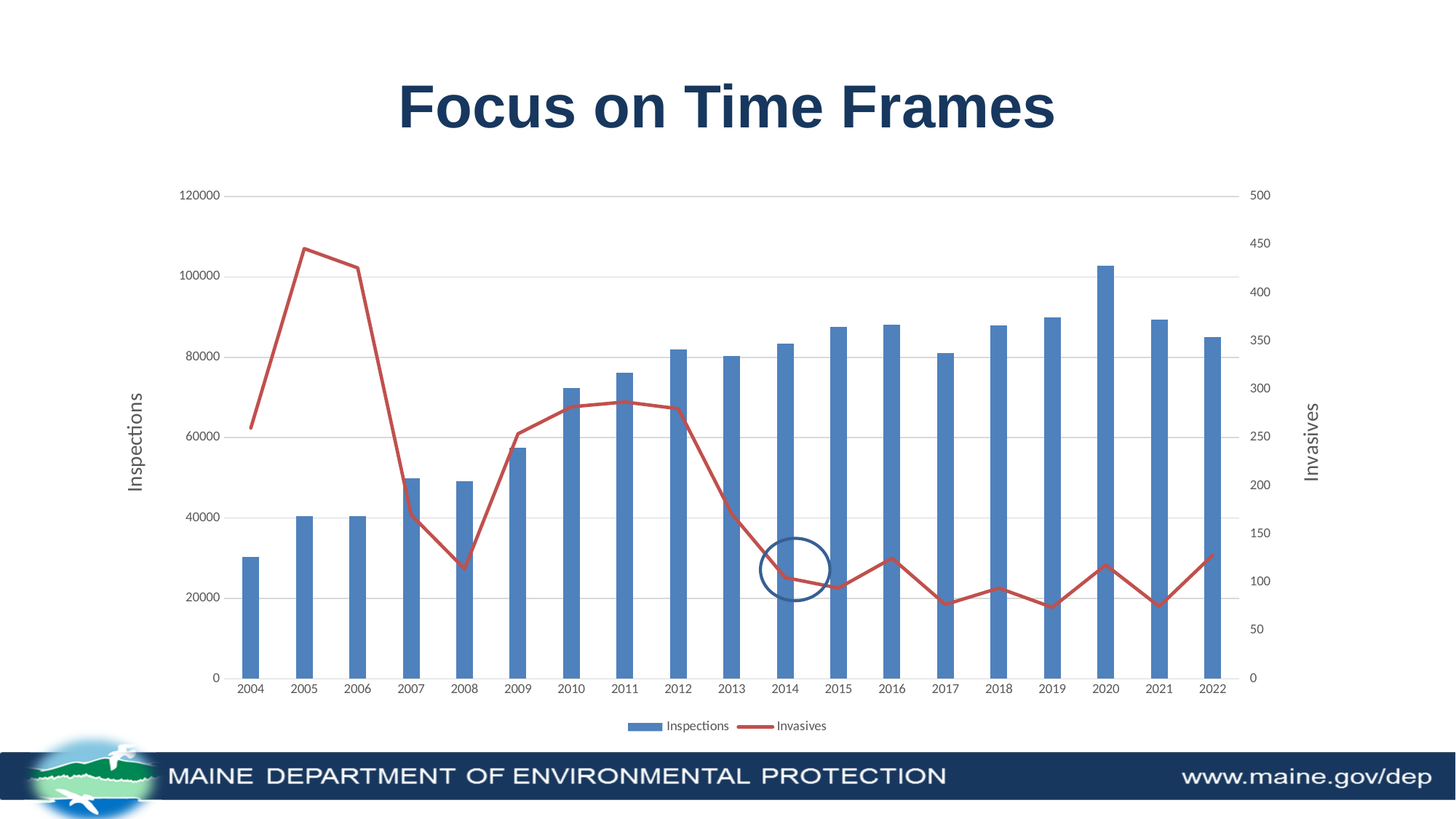
How many series does the chart's legend list? 2 What kind of chart is shown on the slide? A combination bar and line chart Is the Inspections value for 2020 greater or less than 100000? greater Which year has the lowest number of Inspections? 2004 Which year has the highest number of Inspections? 2020 What is the label on the right-hand vertical axis of the chart? Invasives How many years are shown along the x axis of the chart? 19 Which year has the highest value for Invasives? 2005 Does the Invasives line rise or fall from 2005 to 2008? fall Is the Invasives value for 2005 greater or less than 400? greater Is the Inspections value for 2004 greater or less than 40000? less Which year has more Inspections, 2005 or 2010? 2010